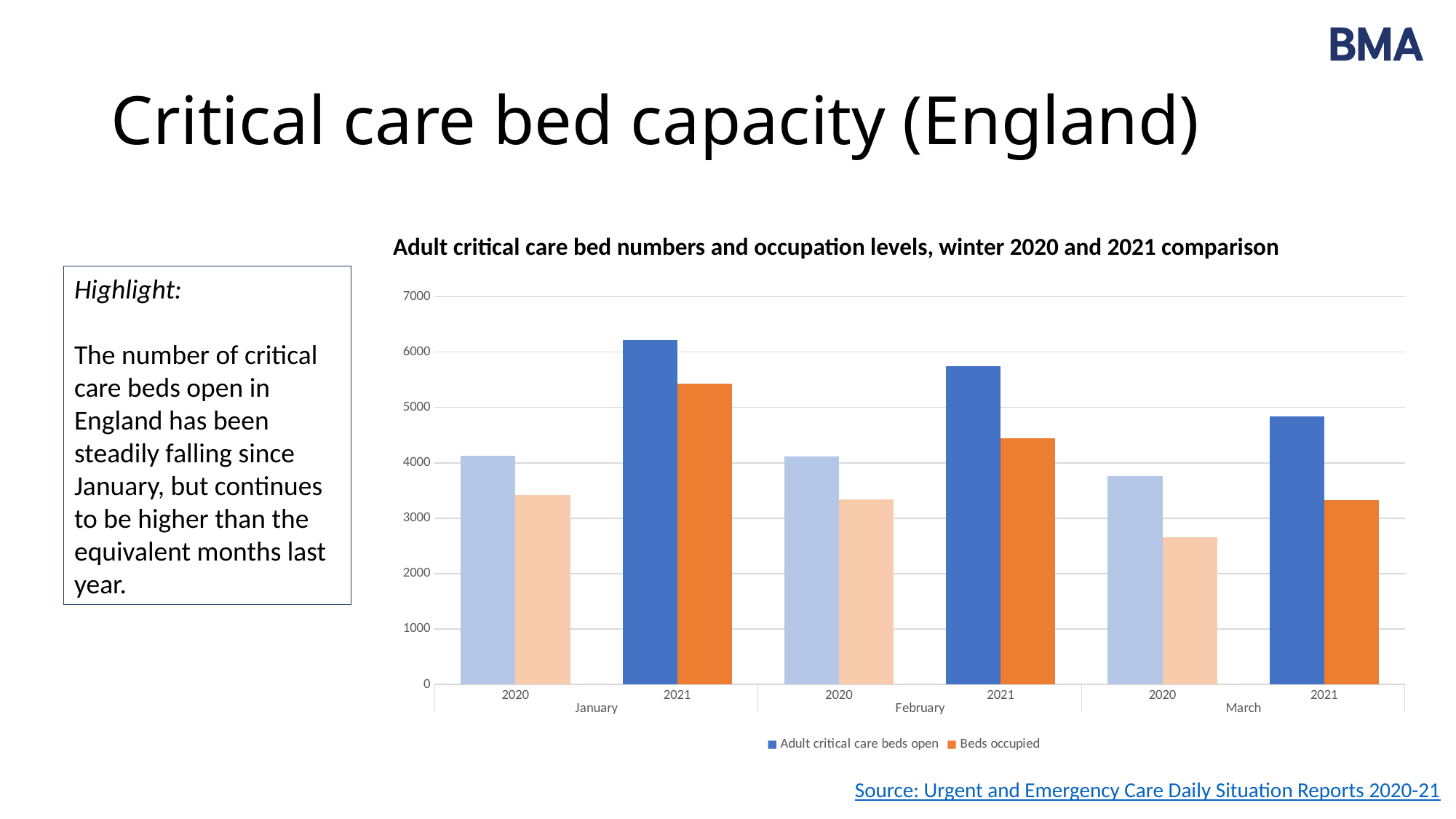
Which is larger: adult critical care beds open in March 2021 or adult critical care beds open in January 2020? March 2021 In which month and year is the number of beds occupied lowest? March 2020 What are the two series named in the legend? Adult critical care beds open; Beds occupied Is the value for adult critical care beds open in March 2021 greater or less than 5000? less Is the value for beds occupied in January 2021 greater or less than 5000? greater In which month and year is the number of adult critical care beds open highest? January 2021 Do the adult critical care beds open in 2021 rise or fall from January to March? fall How many month-year groups of bars are plotted on the chart? 6 What type of chart is shown on the slide? Bar chart How many series does the legend list? 2 Is the value for beds occupied in March 2020 greater or less than 3000? less